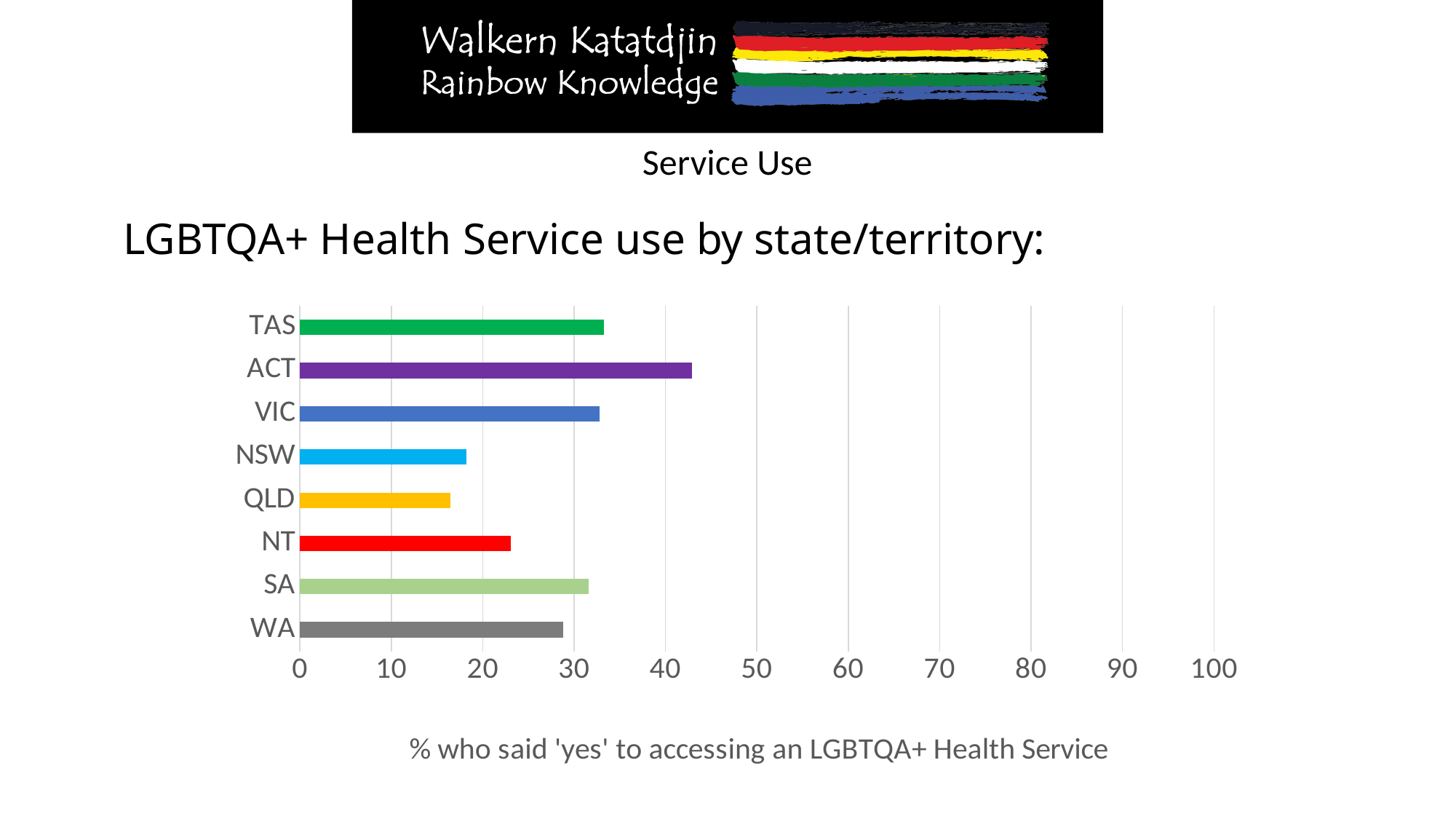
Is the value for WA greater or less than 30? less What is the title of the chart? % who said 'yes' to accessing an LGBTQA+ Health Service What kind of chart is shown on the slide? bar chart Is the value for TAS greater or less than 30? greater Which has a larger value, SA or QLD? SA Is the value for QLD greater or less than 20? less Which state/territory has the highest percentage of people who said 'yes' to accessing an LGBTQA+ Health Service? ACT How many states/territories are shown in the chart? 8 Which has a larger value, NT or NSW? NT